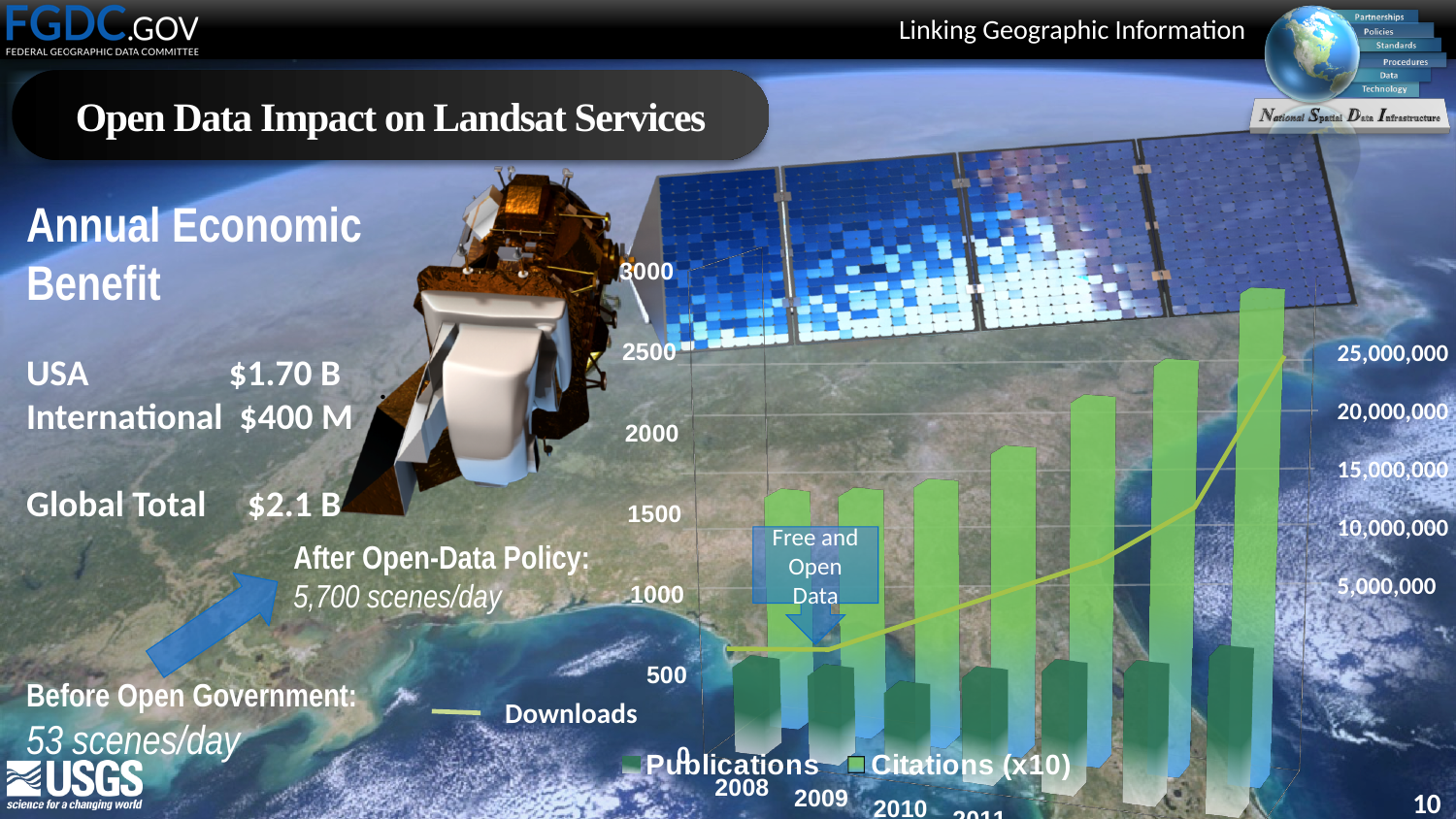
Which year has the higher Citations (x10) value, 2008 or 2011? 2011 Which series is shown by the yellow line on the chart? Downloads What is the highest value labelled on the right-hand axis of the chart? 25,000,000 Does the Downloads line rise or fall from left to right? rise Is the Citations (x10) value for 2008 greater or less than 1000? greater How many series does the legend at the bottom of the chart list? 2 What are the two series named in the legend at the bottom of the chart? Publications and Citations (x10) Do the Citations (x10) bars rise or fall from left to right along the x axis? rise In 2008, which is larger: Publications or Citations (x10)? Citations (x10) Is the Publications value for 2008 greater or less than 1000? less What kind of chart is shown on the slide? bar chart Is the Citations (x10) value for 2011 greater or less than 2500? less